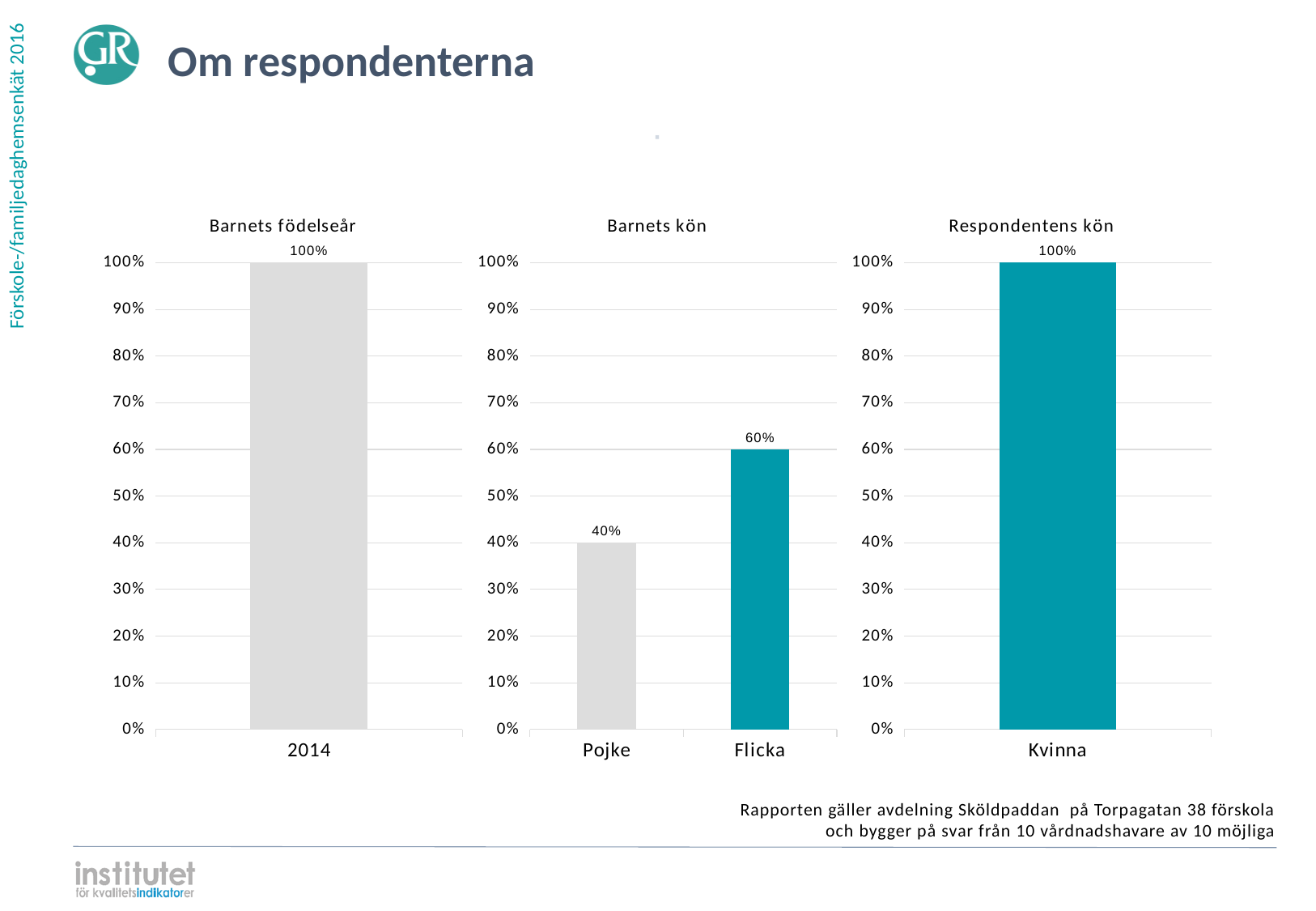
In the 'Respondentens kön' chart, what is the value for Kvinna? 100% In the 'Barnets kön' chart, how many categories are shown on the x axis? 2 In the 'Barnets födelseår' chart, how many categories are shown on the x axis? 1 How many charts are shown on the slide? 3 In the 'Barnets kön' chart, what is the difference between the values for Flicka and Pojke? 20% In the 'Barnets kön' chart, what is the value for Pojke? 40% In the 'Barnets födelseår' chart, what is the value for 2014? 100% What kind of chart is the 'Respondentens kön' chart? Bar chart In the 'Barnets kön' chart, what is the value for Flicka? 60% In the 'Barnets kön' chart, which is larger, the value for Pojke or the value for Flicka? Flicka In the 'Barnets kön' chart, which category has the highest value? Flicka In the 'Barnets kön' chart, which category has the lowest value? Pojke